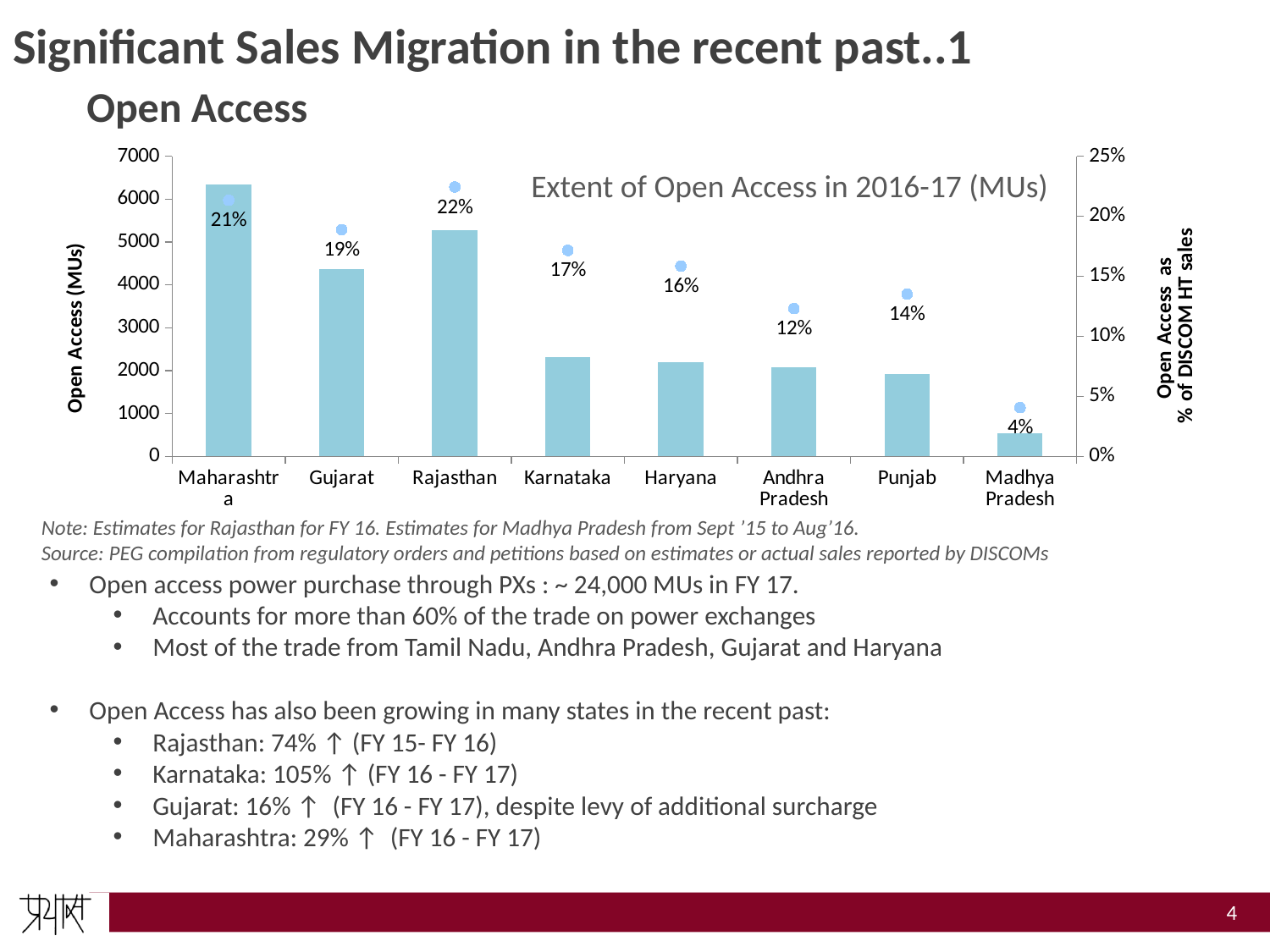
How many states are shown on the x axis of the chart? 8 Which state has the lowest open access as % of DISCOM HT sales? Madhya Pradesh What is the open access share of DISCOM HT sales shown for Rajasthan? 22% Is the open access value in MUs for Gujarat greater or less than 4000? greater Which state has the tallest bar for open access in MUs? Maharashtra What is the title shown inside the chart area? Extent of Open Access in 2016-17 (MUs) Which has a higher open access share of DISCOM HT sales, Punjab or Karnataka? Karnataka Which state has the highest open access as % of DISCOM HT sales? Rajasthan What is the open access as % of DISCOM HT sales for Andhra Pradesh? 12% What percentage label is shown for Madhya Pradesh? 4% What is the difference in percentage points between Gujarat's and Haryana's open access share of DISCOM HT sales? 3 percentage points Is the open access value in MUs for Madhya Pradesh greater or less than 1000? less